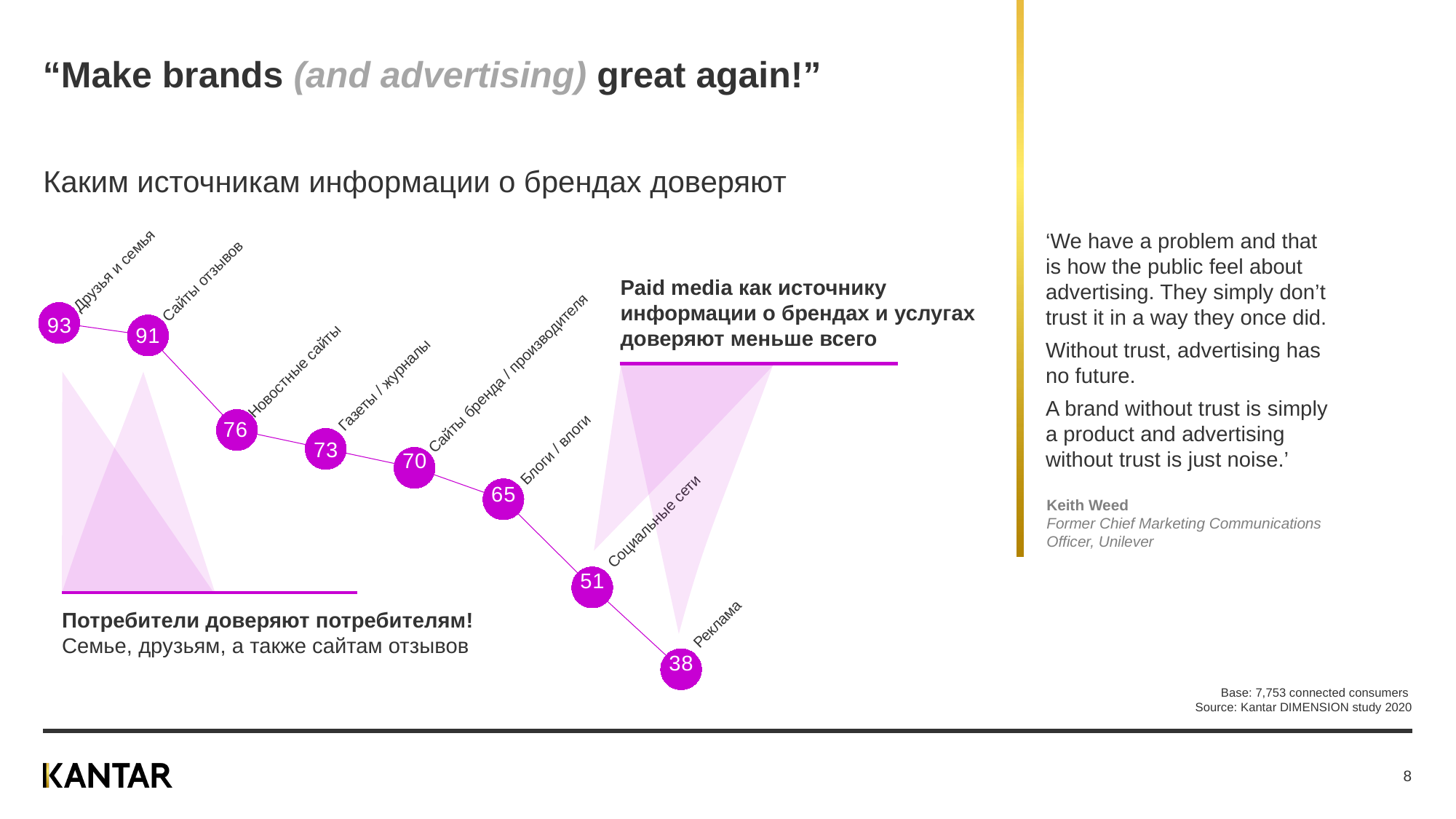
How many sources are plotted on the chart? 8 Do the values rise or fall from left to right along the chart? Fall Which is larger, the value for Сайты бренда / производителя or the value for Социальные сети? Сайты бренда / производителя What is the value for Социальные сети? 51 What kind of chart is shown on the slide? Line chart Which source has the lowest value? Реклама What is the value for Сайты отзывов? 91 What is the difference between the values for Новостные сайты and Газеты / журналы? 3 What is the difference between the values for Друзья и семья and Реклама? 55 Which source has the highest value? Друзья и семья What is the value for Блоги / влоги? 65 What is the value for Друзья и семья? 93